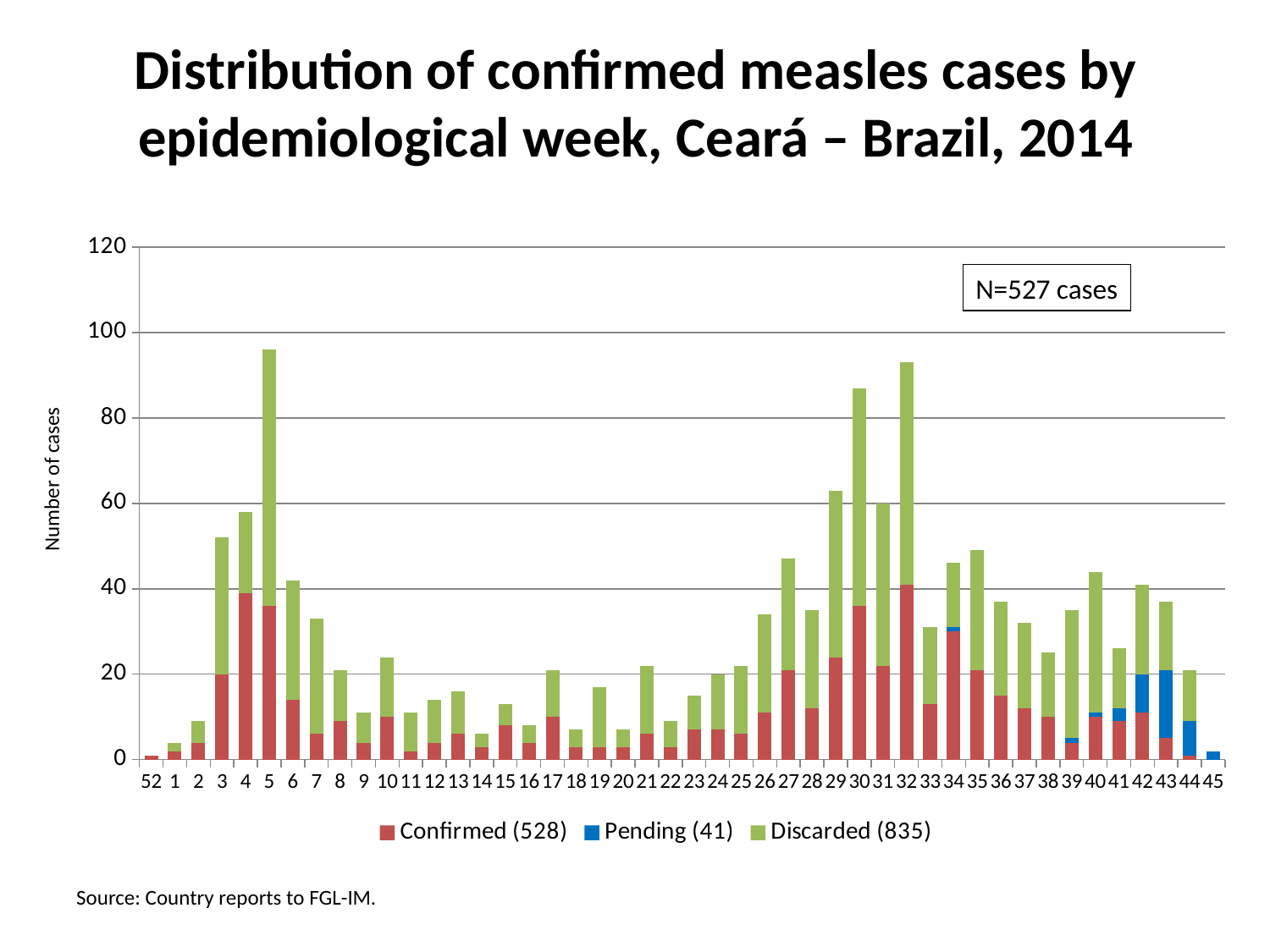
What is the label on the y axis? Number of cases Is the total bar height for week 14 greater or less than 20? less Which has the taller stacked bar, week 30 or week 31? Week 30 What are the three series named in the legend? Confirmed (528), Pending (41), Discarded (835) Do the stacked bar totals rise or fall from week 25 to week 30? Rise Is the total bar height for week 5 greater or less than 80? greater What kind of chart is shown on the slide? Stacked bar chart Which epidemiological week has the tallest stacked bar? 5 Is the total bar height for week 27 greater or less than 40? greater How many epidemiological weeks are shown on the x axis? 46 How many series does the legend list? 3